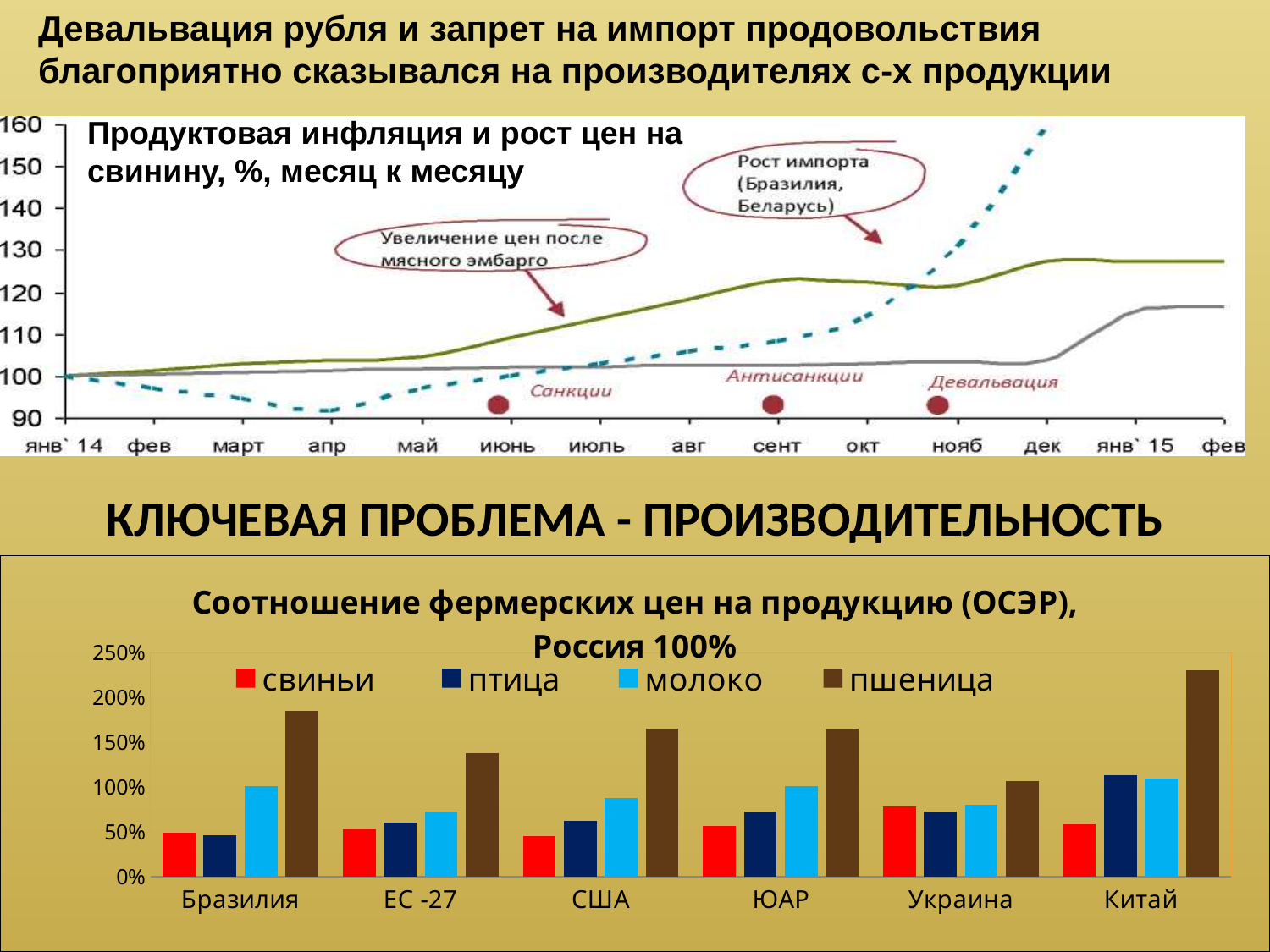
In the top line chart, how many month labels are shown on the x axis? 14 In the bottom bar chart, how many countries/regions are shown on the x axis? 6 In the top line chart, does the dashed line rise or fall between окт and дек? rise In the bottom bar chart, is the value for свиньи in Украина greater or less than 50%? greater In the bottom bar chart, which is larger: the value for свиньи in Украина or the value for свиньи in Бразилия? Украина In the bottom bar chart, how many series does the legend list? 4 In the bottom bar chart, which series is shown in red? свиньи In the bottom bar chart, is the value for пшеница in Китай greater or less than 200%? greater What kind of chart is the bottom chart titled 'Соотношение фермерских цен на продукцию (ОСЭР), Россия 100%'? bar chart What kind of chart is the top chart titled 'Продуктовая инфляция и рост цен на свинину, %, месяц к месяцу'? line chart In the bottom bar chart, is the value for пшеница in ЕС -27 greater or less than 150%? less In the bottom bar chart, which country has the highest value for пшеница? Китай